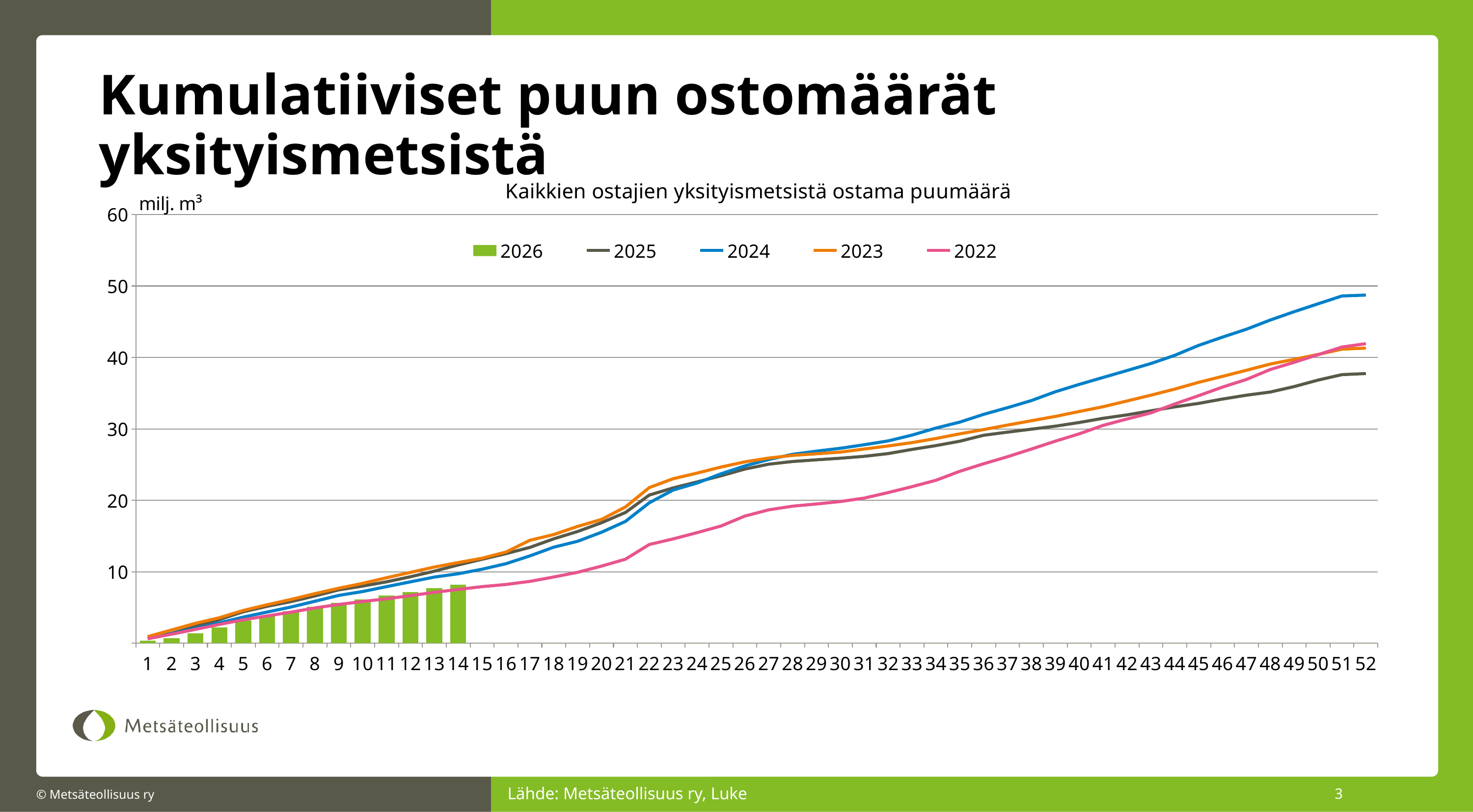
How many weeks are shown on the x axis? 52 What kind of chart is this? A combined bar and line chart At week 30, which is larger: the value for 2022 or the value for 2024? 2024 Which line series has the lowest value at week 52? 2025 Is the value for 2024 at week 52 greater or less than 40? greater Which series has the highest value at week 52? 2024 Which series is plotted as bars rather than a line? 2026 What unit is shown on the y axis? milj. m³ How many series does the legend list? 5 Up to which week do the 2026 bars extend? 14 Is the value for 2025 at week 52 greater or less than 40? less Do the line series rise or fall along the x axis? rise